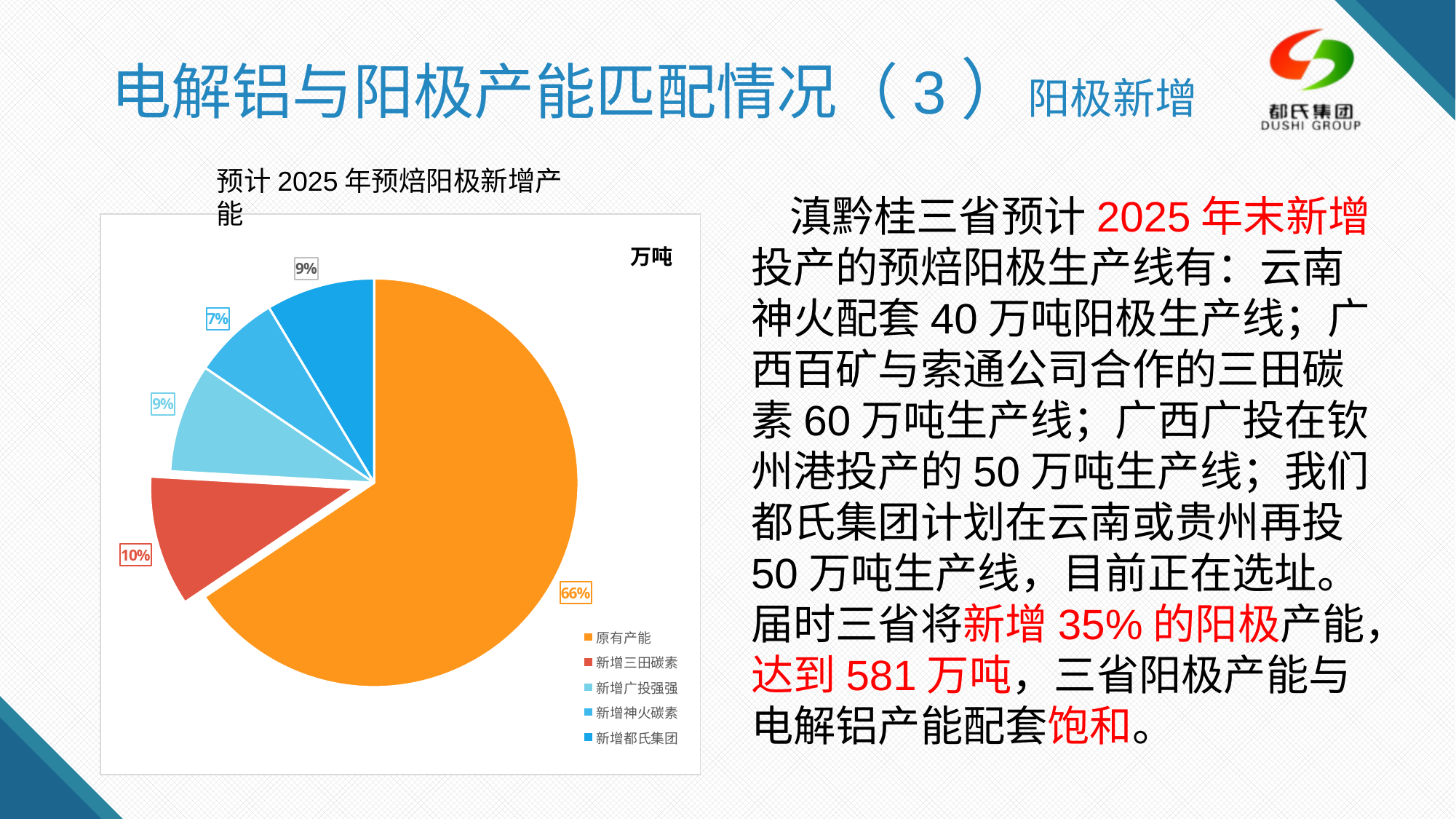
How many slices does the pie chart have? 5 What percentage is shown for 新增神火碳素? 7% Which category has the smallest slice in the pie chart? 新增神火碳素 What percentage is shown for 新增三田碳素? 10% What is the difference in percentage points between 原有产能 and 新增三田碳素? 56 What percentage is shown for 新增都氏集团? 9% What is the title of the pie chart? 预计 2025 年预焙阳极新增产能 What share of the pie does 原有产能 account for? 66% Which is larger, the share for 新增三田碳素 or the share for 新增神火碳素? 新增三田碳素 Which category has the largest slice in the pie chart? 原有产能 How many entries does the legend of the pie chart list? 5 What kind of chart is shown on the slide? pie chart